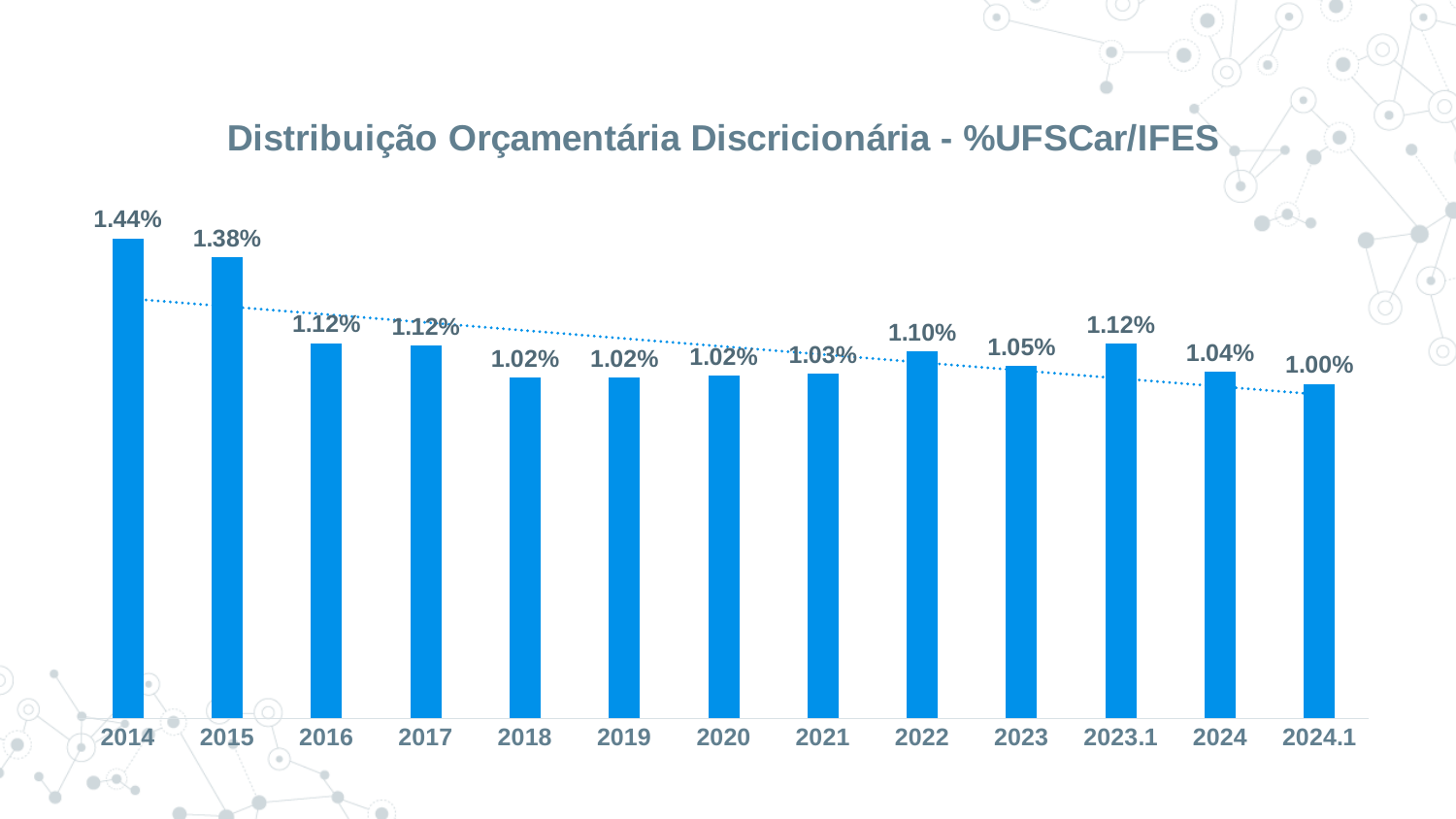
What is the value for 2014? 1.44% What is the title of the chart? Distribuição Orçamentária Discricionária - %UFSCar/IFES What kind of chart is this? bar chart Which is larger, the value for 2021 or the value for 2022? 2022 Do the values generally rise or fall from 2014 to 2024.1? fall What is the difference between the values for 2014 and 2015? 0.06% Which category has the lowest value? 2024.1 Which year has the highest value? 2014 What is the value for 2022? 1.10% What is the difference between the values for 2023.1 and 2024? 0.08% What is the value for 2024.1? 1.00% How many categories are shown on the x axis? 13